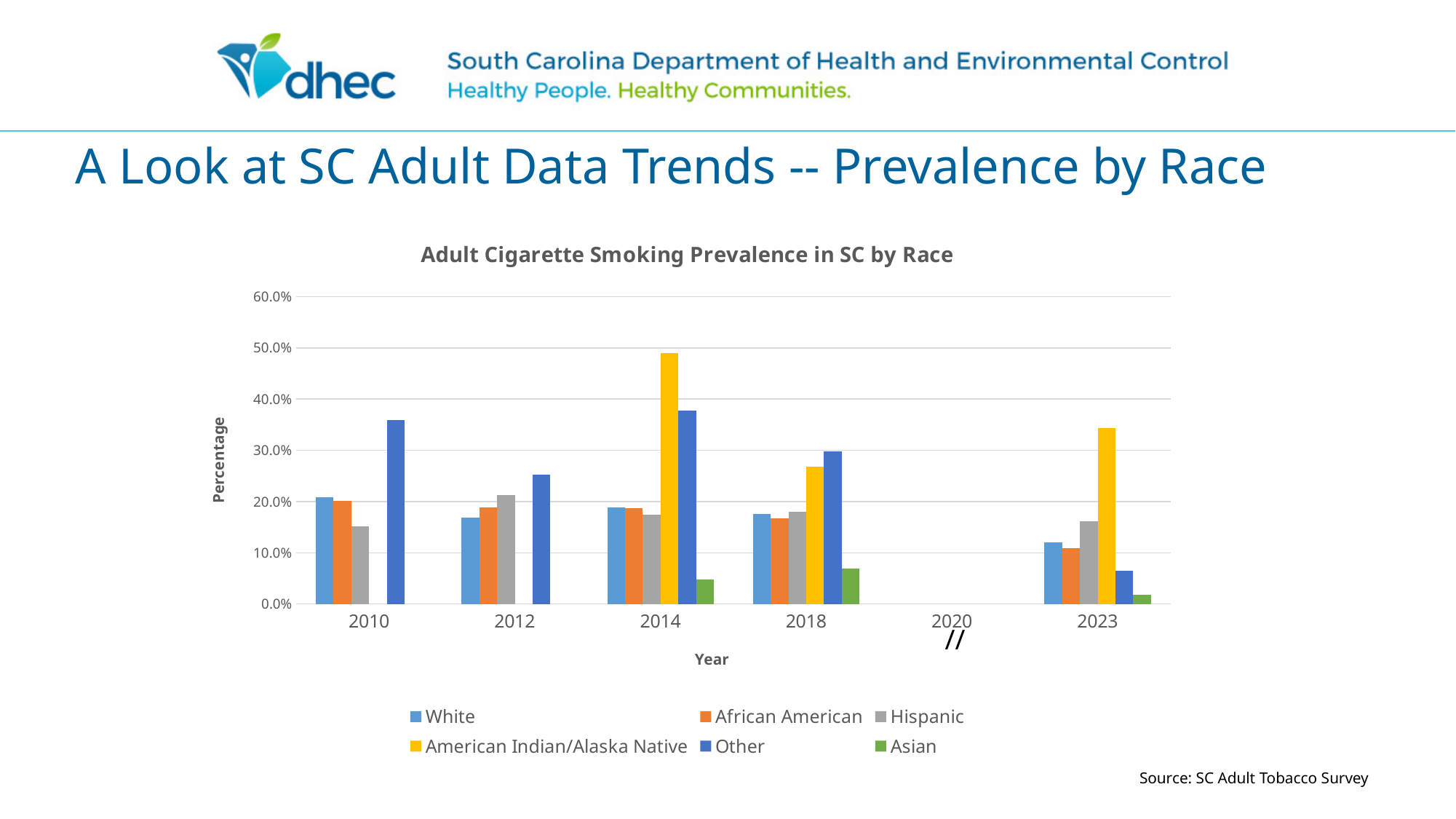
What is the title of the chart? Adult Cigarette Smoking Prevalence in SC by Race Is the value for Asian in 2014 greater or less than 10.0%? less How many years are labelled on the x axis? 6 In 2023, which is larger: the value for American Indian/Alaska Native or the value for Other? American Indian/Alaska Native Is the value for Other in 2010 greater or less than 30.0%? greater Is the value for American Indian/Alaska Native in 2014 greater or less than 40.0%? greater Is the value for White in 2023 higher or lower than the value for White in 2010? lower Which race group has the highest smoking prevalence in 2010? Other Which race group has the highest smoking prevalence in 2014? American Indian/Alaska Native What kind of chart is shown on the slide? bar chart Which race group has the lowest smoking prevalence in 2023? Asian How many series does the legend list? 6